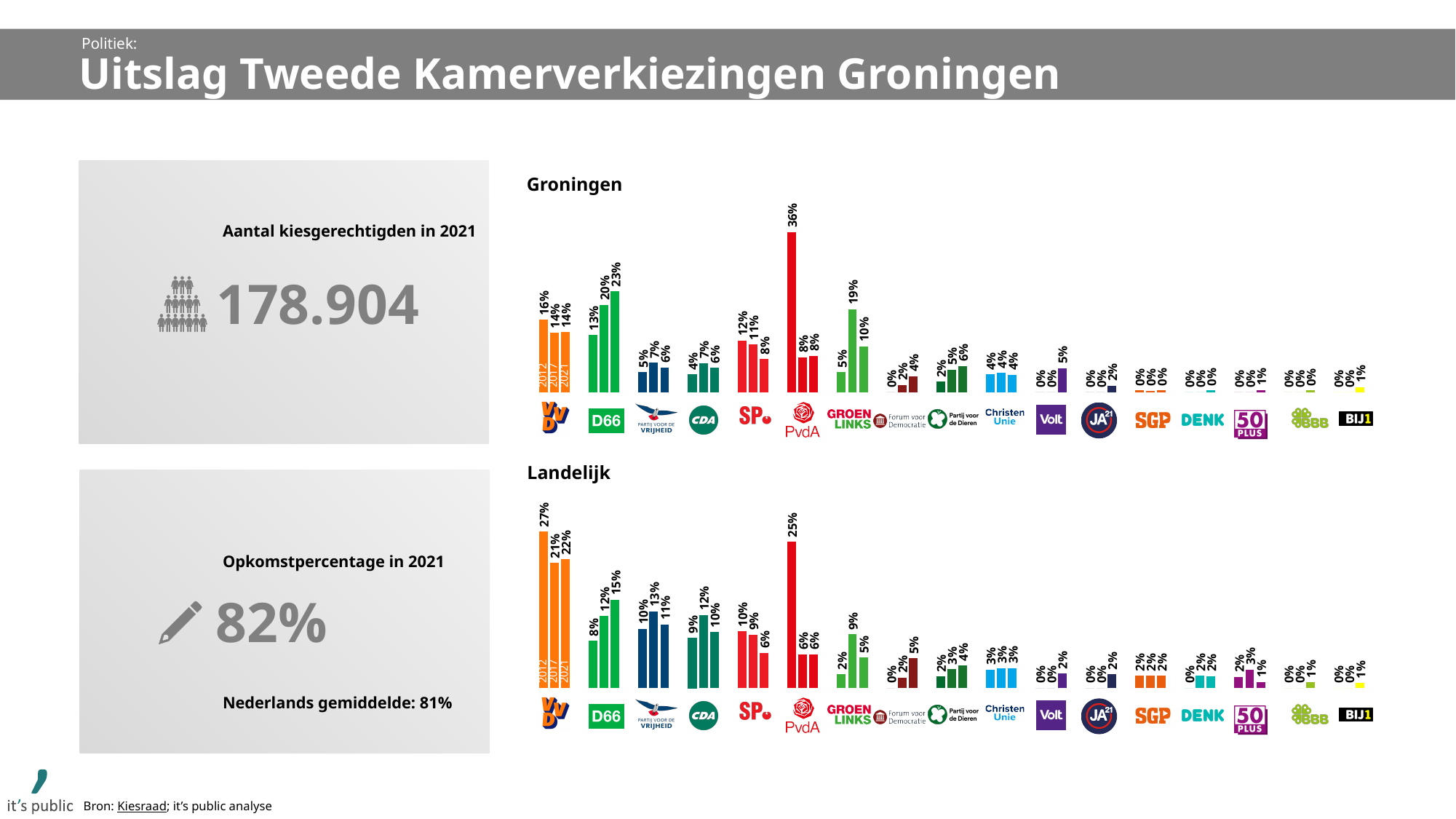
In the Landelijk chart, do SP's values rise or fall from 2012 to 2021? fall In the Groningen chart, what percentage did D66 get in 2021? 23% In the Landelijk chart, which party has the highest bar for 2021? VVD In the Landelijk chart, what is the difference between D66's 2021 and 2012 percentages? 7% In the Landelijk chart, what percentage did VVD get in 2012? 27% In the Groningen chart, which party has the highest bar for 2021? D66 In the Landelijk chart, what percentage did GroenLinks get in 2017? 9% In the Groningen chart, do D66's values rise or fall from 2012 to 2021? rise What type of chart is used for the Groningen and Landelijk results? bar chart In the Groningen chart, what is the difference between PvdA's 2012 and 2017 percentages? 28% In the Groningen chart, what percentage did PvdA get in 2012? 36% In the Groningen chart, which is larger: GroenLinks in 2017 or SP in 2017? GroenLinks in 2017